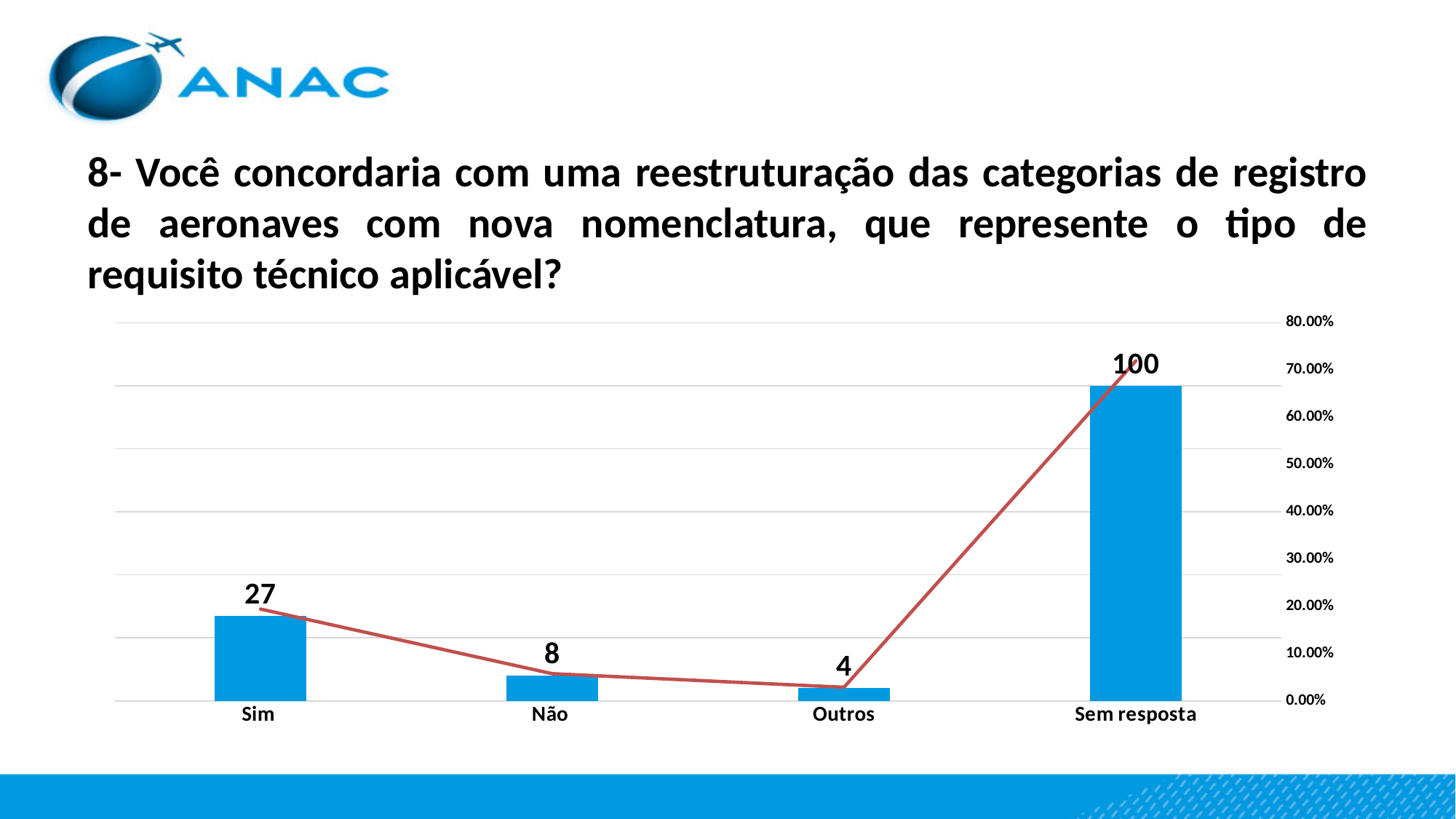
What is the data label shown for the 'Sem resposta' category? 100 What kind of chart is shown on the slide? Bar chart with a line overlay Which category has the highest value? Sem resposta How many categories are shown on the x axis? 4 What is the data label shown for the 'Sim' category? 27 On the percentage axis, is the bar for 'Sem resposta' greater or less than 60.00%? greater Which category has the lowest value? Outros What is the data label shown for the 'Não' category? 8 What is the difference between the labelled values for 'Não' and 'Outros'? 4 What is the difference between the labelled values for 'Sem resposta' and 'Sim'? 73 Which has a larger value, 'Sim' or 'Não'? Sim What is the data label shown for the 'Outros' category? 4